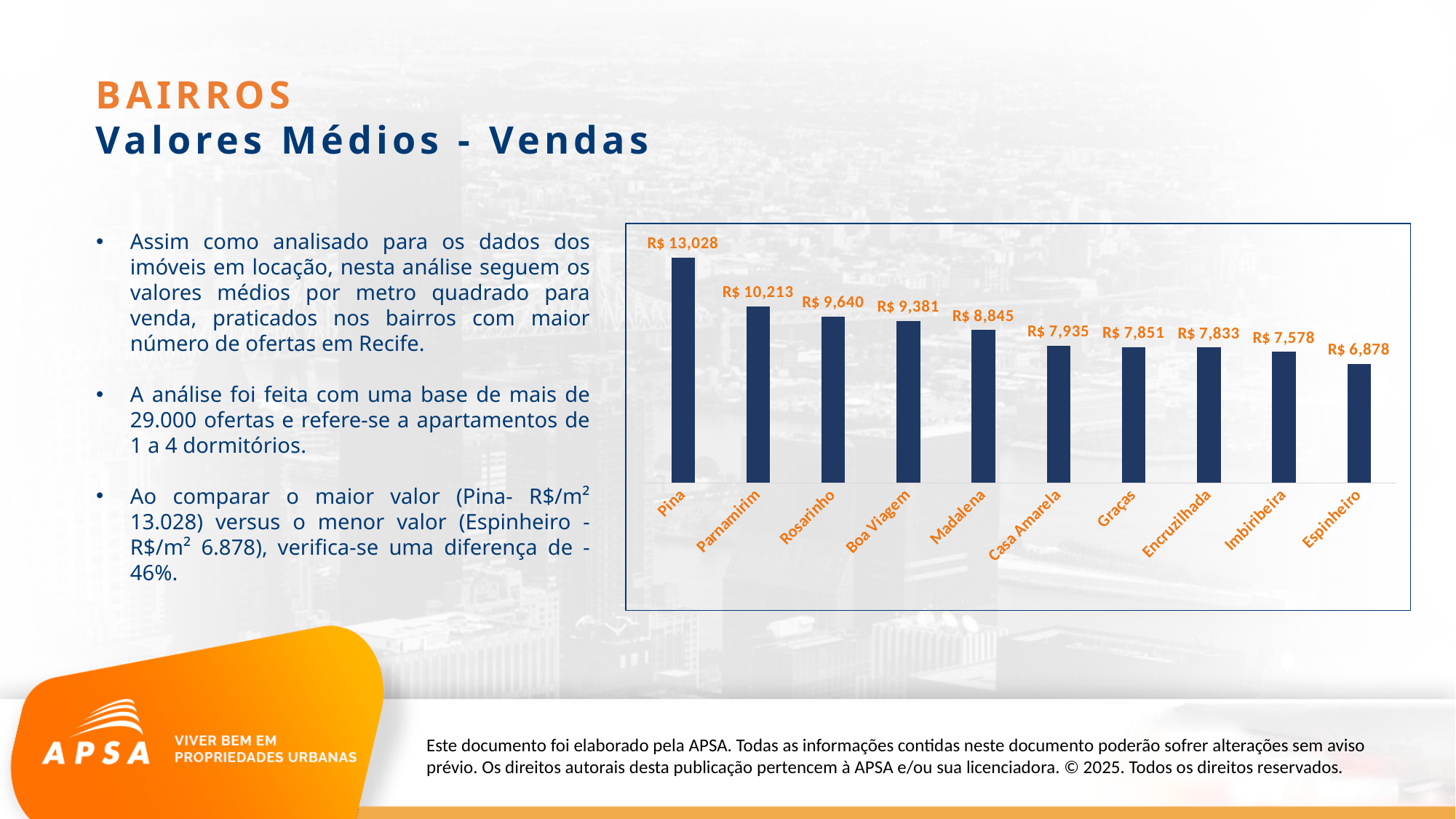
What value is shown for Imbiribeira? R$ 7,578 Which neighbourhood has the lowest value in the chart? Espinheiro What is the average sale value per square metre shown for Pina? R$ 13,028 What is the difference between the values for Parnamirim and Rosarinho? R$ 573 Do the values rise or fall from left to right across the chart? Fall What value is shown for Boa Viagem? R$ 9,381 How many neighbourhoods are shown in the chart? 10 What value is shown for Casa Amarela? R$ 7,935 Which neighbourhood has the highest value in the chart? Pina Which has a higher value, Rosarinho or Boa Viagem? Rosarinho What type of chart is shown on the slide? Bar chart What is the difference between the values for Pina and Espinheiro? R$ 6,150